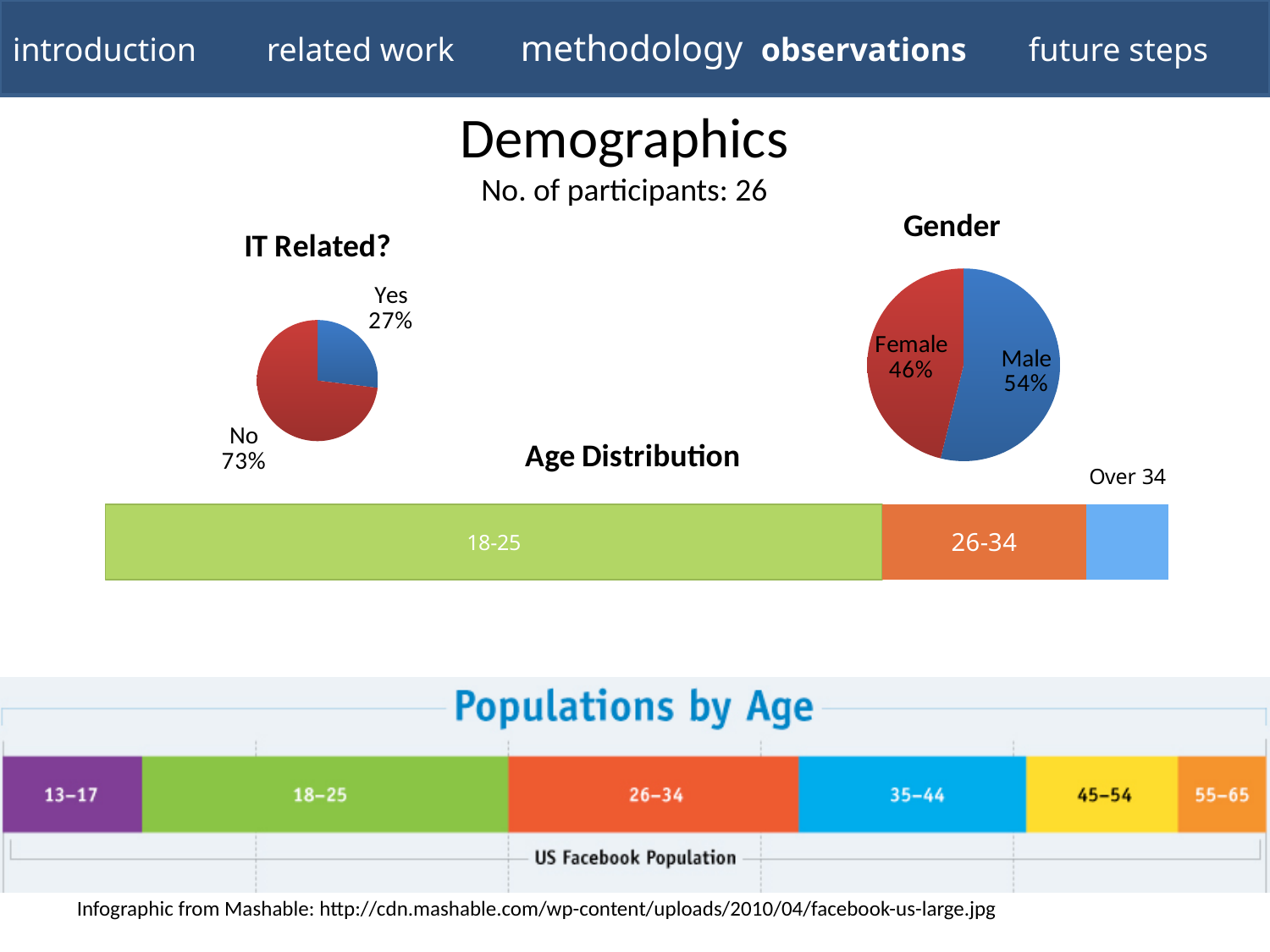
In the "Gender" chart, what percentage of participants are Female? 46% In the "Gender" chart, which slice is larger, Male or Female? Male In the "Age Distribution" bar, which age group takes up the smallest segment? Over 34 In the "Gender" chart, what percentage of participants are Male? 54% In the "IT Related?" chart, what share of participants answered Yes? 27% In the "IT Related?" chart, what is the difference in percentage points between No and Yes? 46 In the "Age Distribution" bar, which age group takes up the largest segment? 18-25 In the "Gender" chart, what is the difference in percentage points between Male and Female? 8 In the "IT Related?" chart, what share of participants answered No? 73% In the "IT Related?" chart, which slice is the largest? No How many age groups are shown in the "Age Distribution" bar? 3 What kind of chart is the "Gender" chart? Pie chart